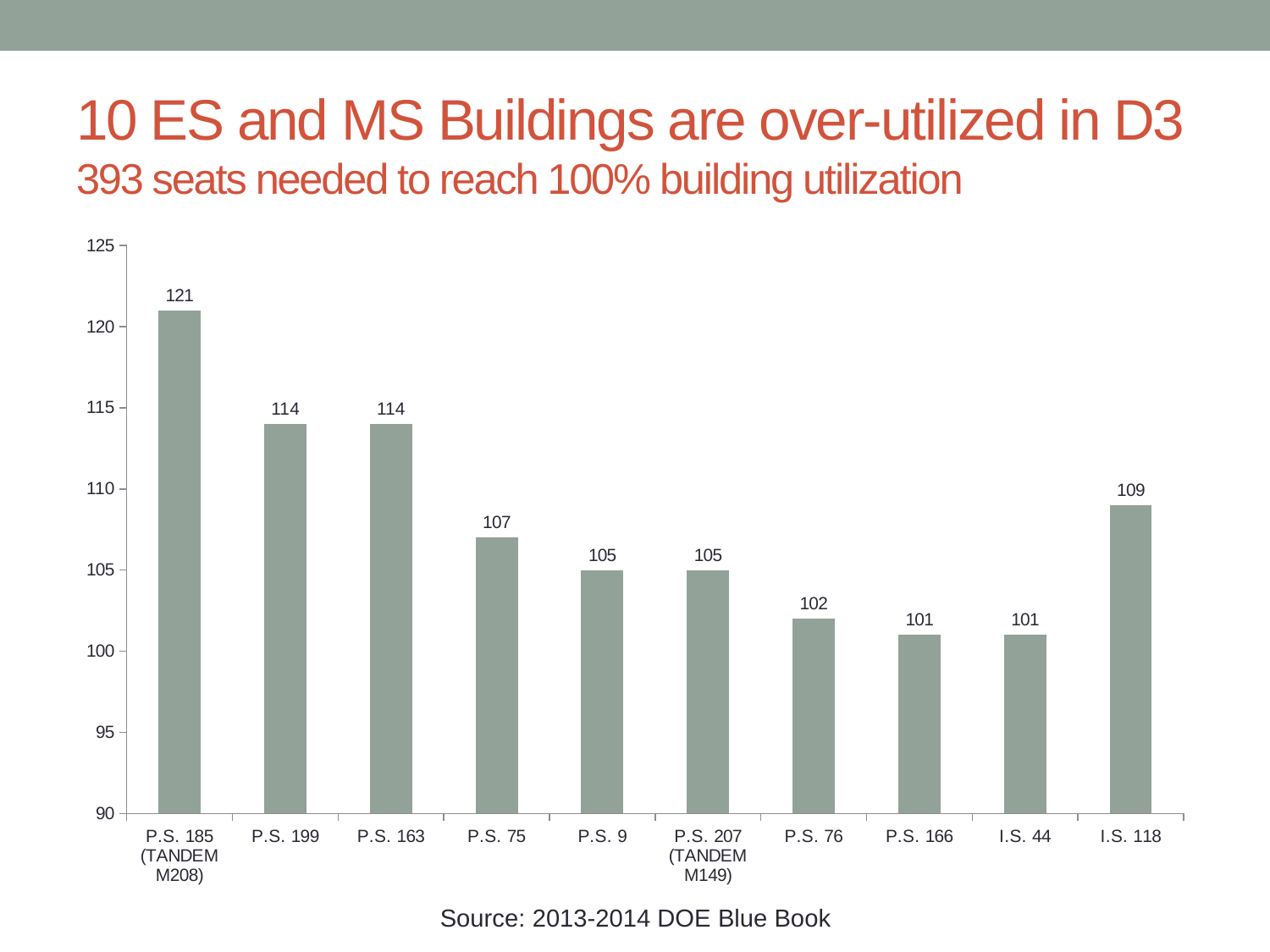
What source is cited below the chart? 2013-2014 DOE Blue Book Which category has the highest value? P.S. 185 (TANDEM M208) What is the value for P.S. 185 (TANDEM M208)? 121 Which is larger, the value for P.S. 163 or the value for P.S. 9? P.S. 163 What is the value for I.S. 118? 109 How many categories are shown on the chart? 10 What kind of chart is shown on the slide? bar chart What is the difference between the values for I.S. 118 and I.S. 44? 8 What is the difference between the values for P.S. 185 (TANDEM M208) and P.S. 199? 7 What is the value for P.S. 76? 102 What is the value for P.S. 75? 107 Is the value for P.S. 207 (TANDEM M149) greater or less than 110? less